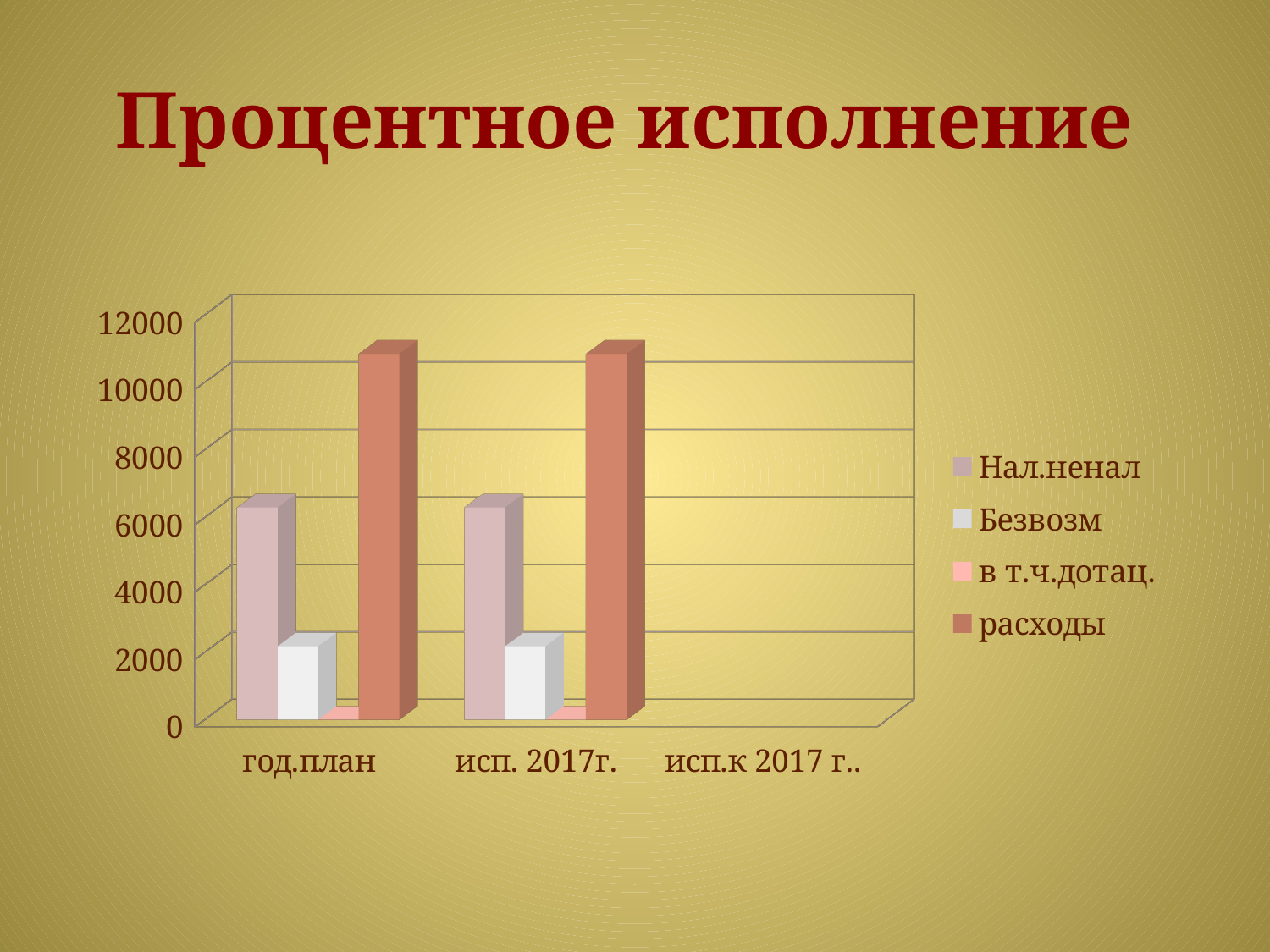
Is the value for Нал.ненал in исп. 2017г. greater or less than 8000? less Which series has the lowest value in the исп. 2017г. category? в т.ч.дотац. How many series does the legend list? 4 What kind of chart is shown on the slide? bar chart Which series has the highest value in the год.план category? расходы What is the title of the slide? Процентное исполнение Is the value for в т.ч.дотац. in год.план greater or less than 2000? less Is the value for Безвозм in год.план greater or less than 4000? less What is the last entry listed in the legend? расходы In the исп. 2017г. category, which is larger: Нал.ненал or Безвозм? Нал.ненал How many categories are shown on the x axis? 3